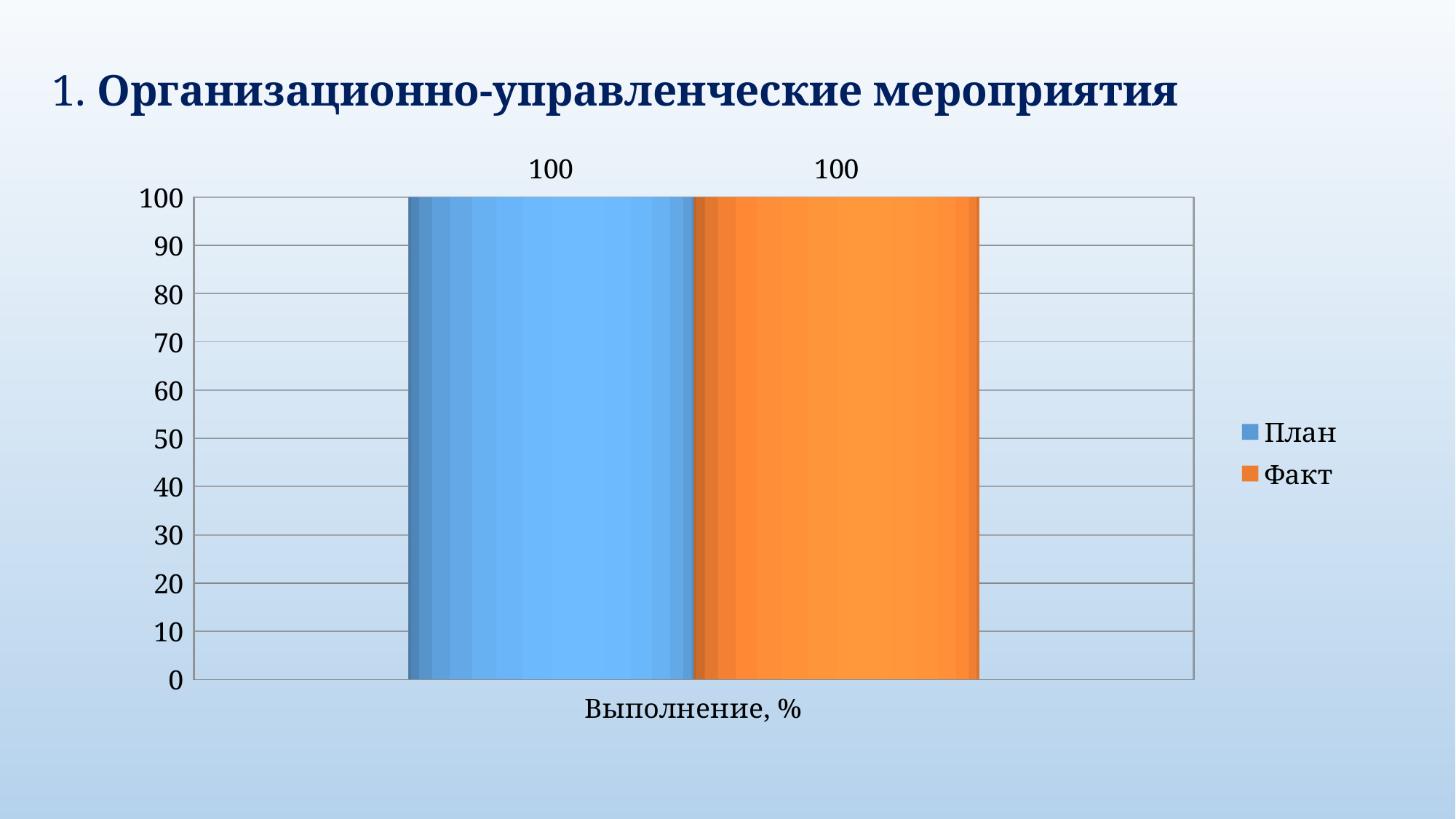
Is the value for Факт greater or less than 50? greater How many series does the legend list? 2 What is the value of the План series for Выполнение, %? 100 Which series is shown in orange? Факт What is the highest value shown on the vertical axis? 100 What kind of chart is shown on the slide? bar chart How many categories are shown on the x axis? 1 What is the difference between the План and Факт values for Выполнение, %? 0 What is the label of the category on the x axis? Выполнение, % What is the value of the Факт series for Выполнение, %? 100